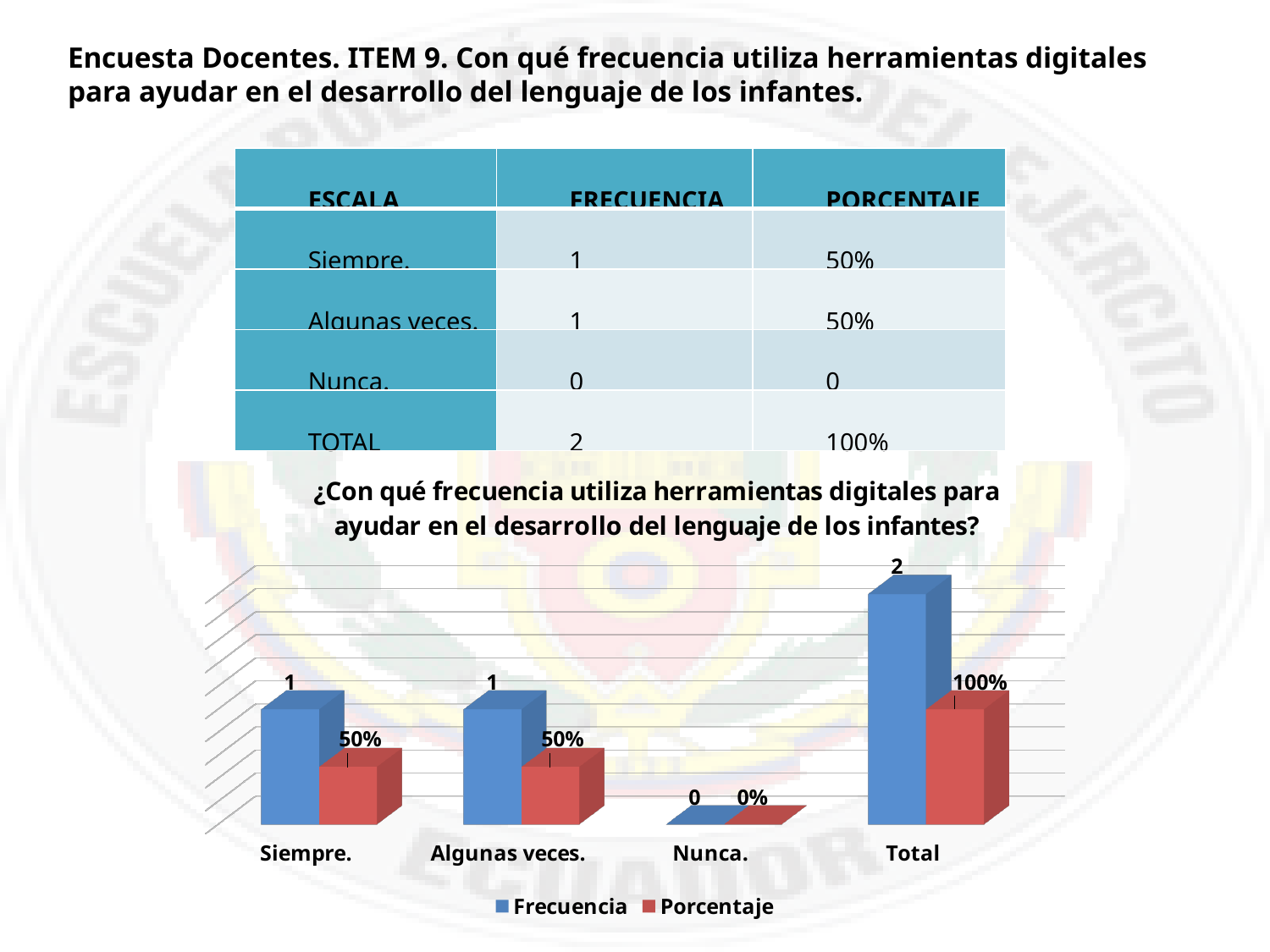
Which category has the highest Frecuencia value? Total What is the Frecuencia value for Siempre? 1 How many categories are shown on the x axis of the chart? 4 What is the difference between the Frecuencia values for Total and Siempre? 1 Which is larger, the Frecuencia value for Algunas veces or the Frecuencia value for Nunca? Algunas veces. What is the Porcentaje value for Algunas veces? 50% How many series does the chart legend list? 2 Which colour represents the Porcentaje series in the chart? Red What is the Porcentaje value for Nunca? 0% Which category has the lowest Porcentaje value? Nunca. What kind of chart is shown on the slide? Bar chart What is the Frecuencia value for Total? 2